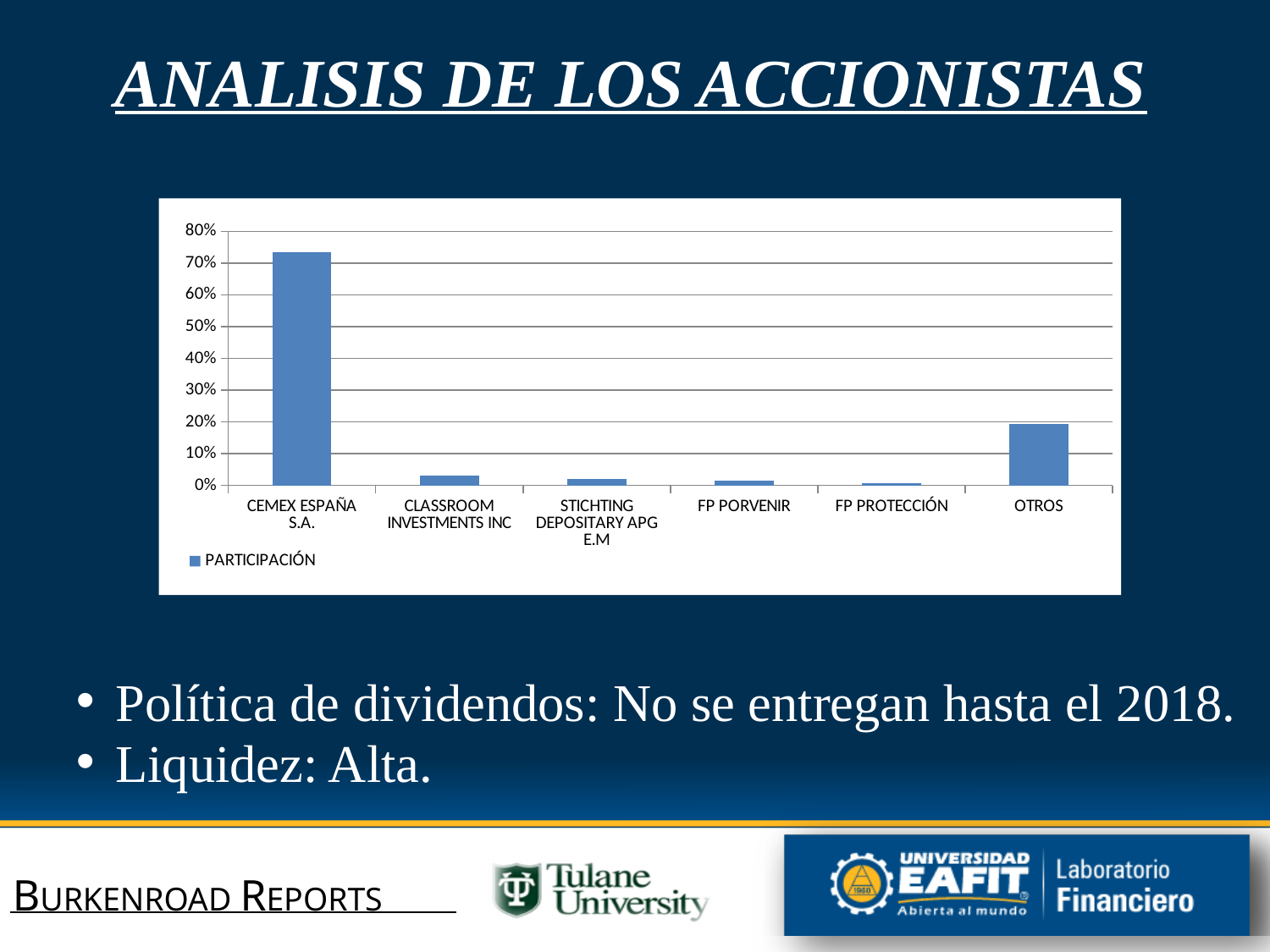
Which has a larger value, CEMEX ESPAÑA S.A. or OTROS? CEMEX ESPAÑA S.A. What is the highest value shown on the chart's vertical axis? 80% Which category has the highest value in the chart? CEMEX ESPAÑA S.A. Which category has the lowest value in the chart? FP PROTECCIÓN How many categories are shown on the x axis of the chart? 6 What kind of chart is shown on the slide? Bar chart How many series does the chart's legend list? 1 Is the value for CEMEX ESPAÑA S.A. greater or less than 70%? greater Which has a larger value, OTROS or CLASSROOM INVESTMENTS INC? OTROS Is the value for CLASSROOM INVESTMENTS INC greater or less than 10%? less What is the name of the series shown in the chart's legend? PARTICIPACIÓN